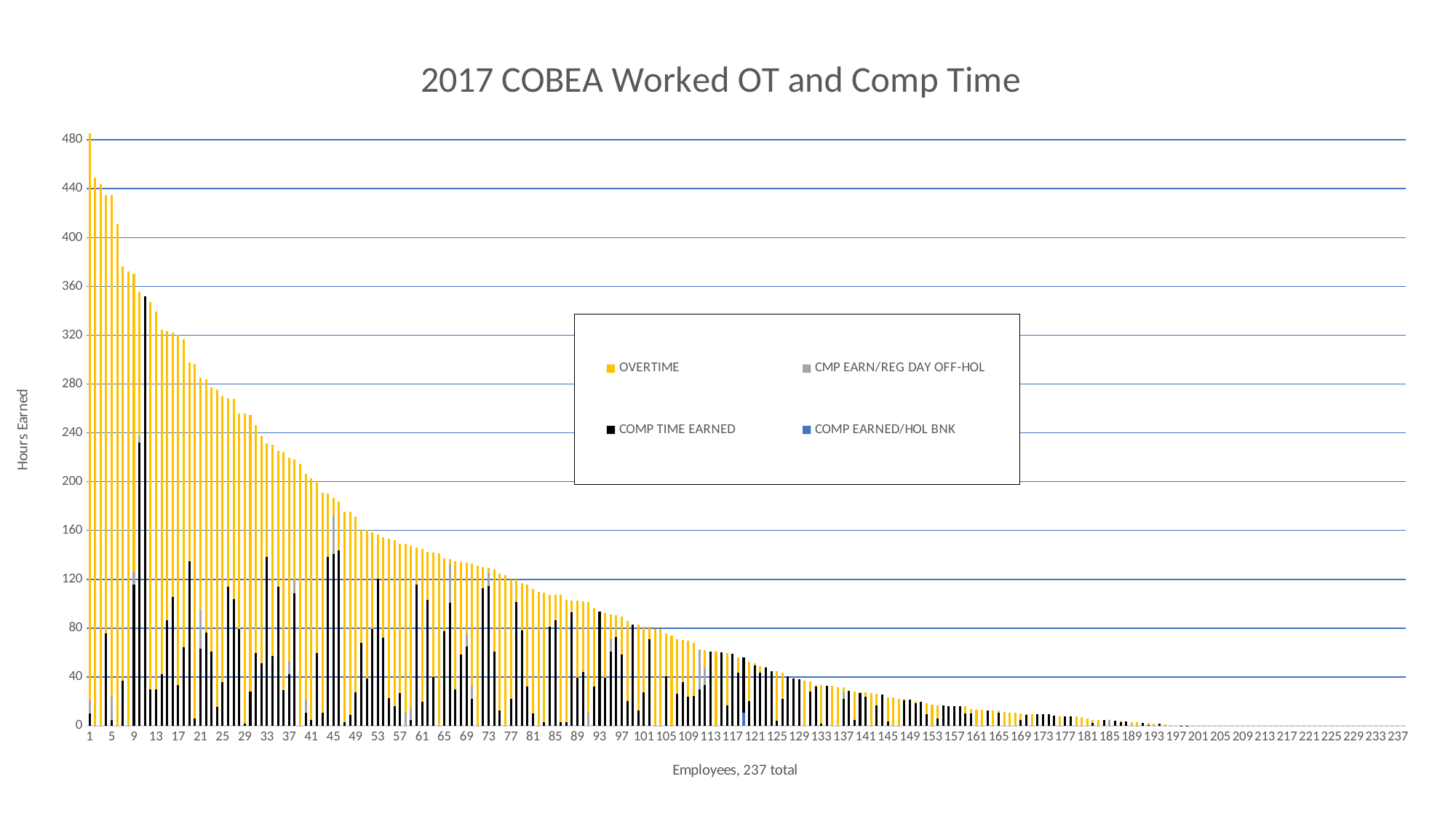
Which is larger, the OVERTIME value for employee 5 or the OVERTIME value for employee 45? employee 5 Which employee number has the highest OVERTIME value? 1 How many series does the legend list? 4 Do the OVERTIME values rise or fall as the employee number increases along the x axis? fall Is the OVERTIME value for employee 101 greater or less than 120? less Is the COMP TIME EARNED value for employee 10 greater or less than 320? less Is the OVERTIME value for employee 1 greater or less than 440? greater What is the label of the y axis? Hours Earned What is the title of the chart? 2017 COBEA Worked OT and Comp Time What kind of chart is shown on the slide? bar chart How many employees are plotted along the x axis, according to the axis title? 237